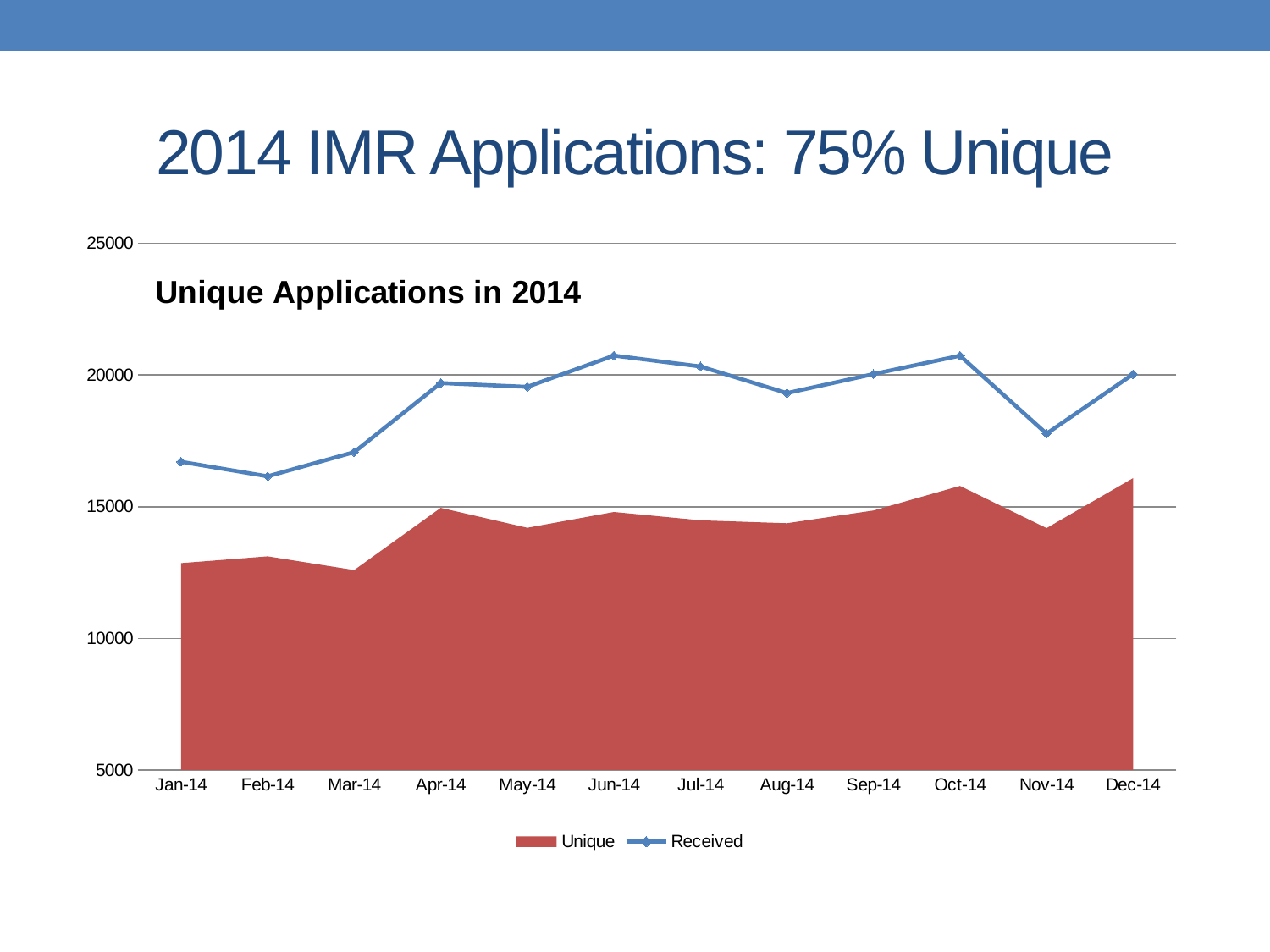
Is the Unique value for Dec-14 greater or less than 15000? greater Which is larger, the Received value for Jun-14 or for Nov-14? Jun-14 What is the title printed inside the chart area? Unique Applications in 2014 What kind of chart is shown on the slide? Area and line chart How many series does the legend list? 2 Is the Received value for Nov-14 greater or less than 20000? less What are the two series named in the legend? Unique and Received Does the Received line rise or fall from Jan-14 to Apr-14? rise Which is larger, the Unique value for Dec-14 or for Jan-14? Dec-14 How many months are plotted along the x axis? 12 Is the Unique value for Jan-14 greater or less than 15000? less